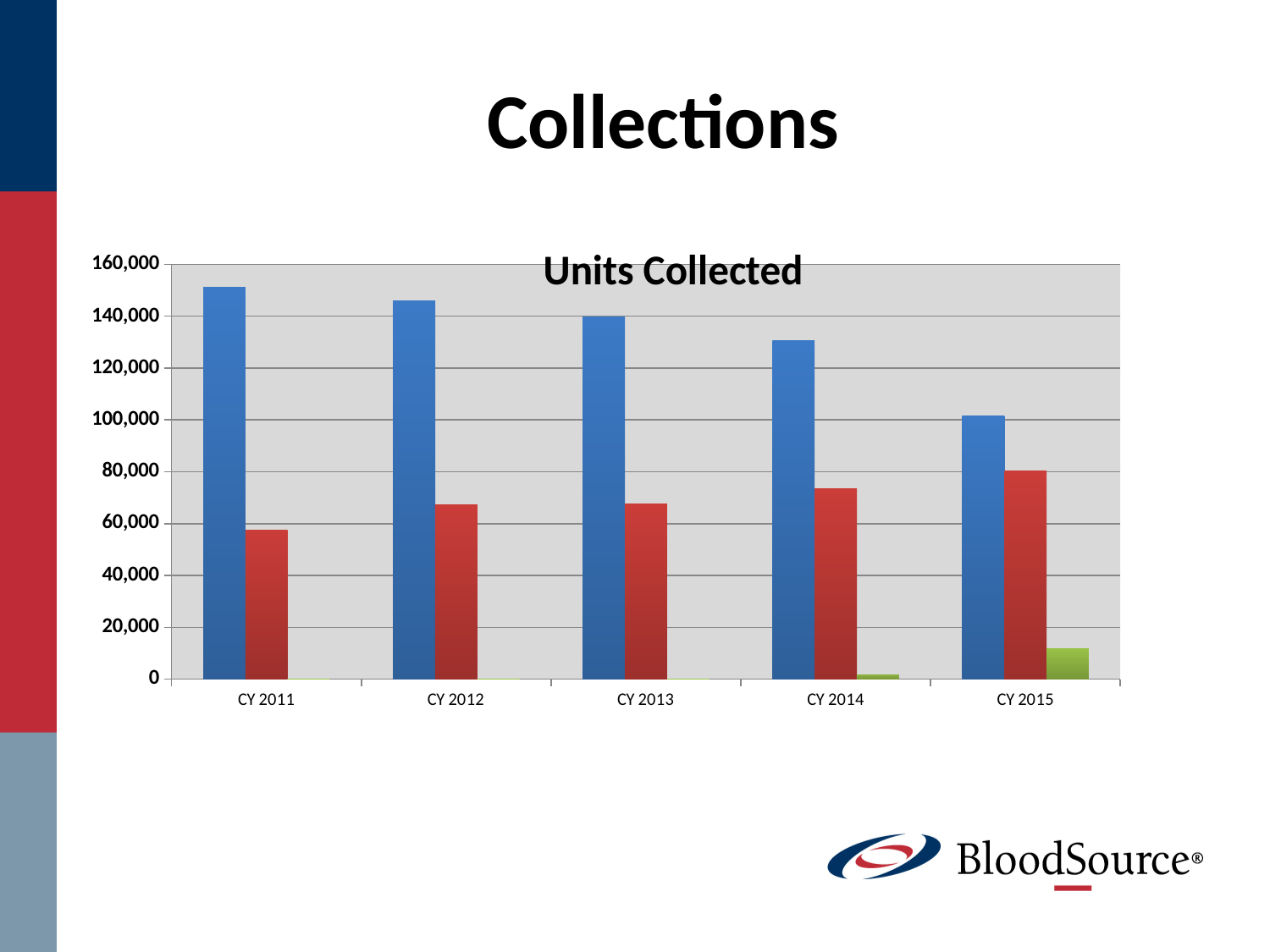
In CY 2015, which is larger, the blue bar or the red bar? the blue bar In which year is the red bar highest? CY 2015 In which year is the blue bar highest? CY 2011 How many series (bar colours) are plotted in the Units Collected chart? 3 What kind of chart is shown on the slide? bar chart In which year is the blue bar lowest? CY 2015 How many categories are shown on the x axis of the Units Collected chart? 5 What is the title of the chart? Units Collected Is the red bar for CY 2015 greater or less than 100,000? less Do the blue bars rise or fall from CY 2011 to CY 2015? fall Is the blue bar for CY 2011 greater or less than 140,000? greater Do the red bars rise or fall from CY 2011 to CY 2015? rise